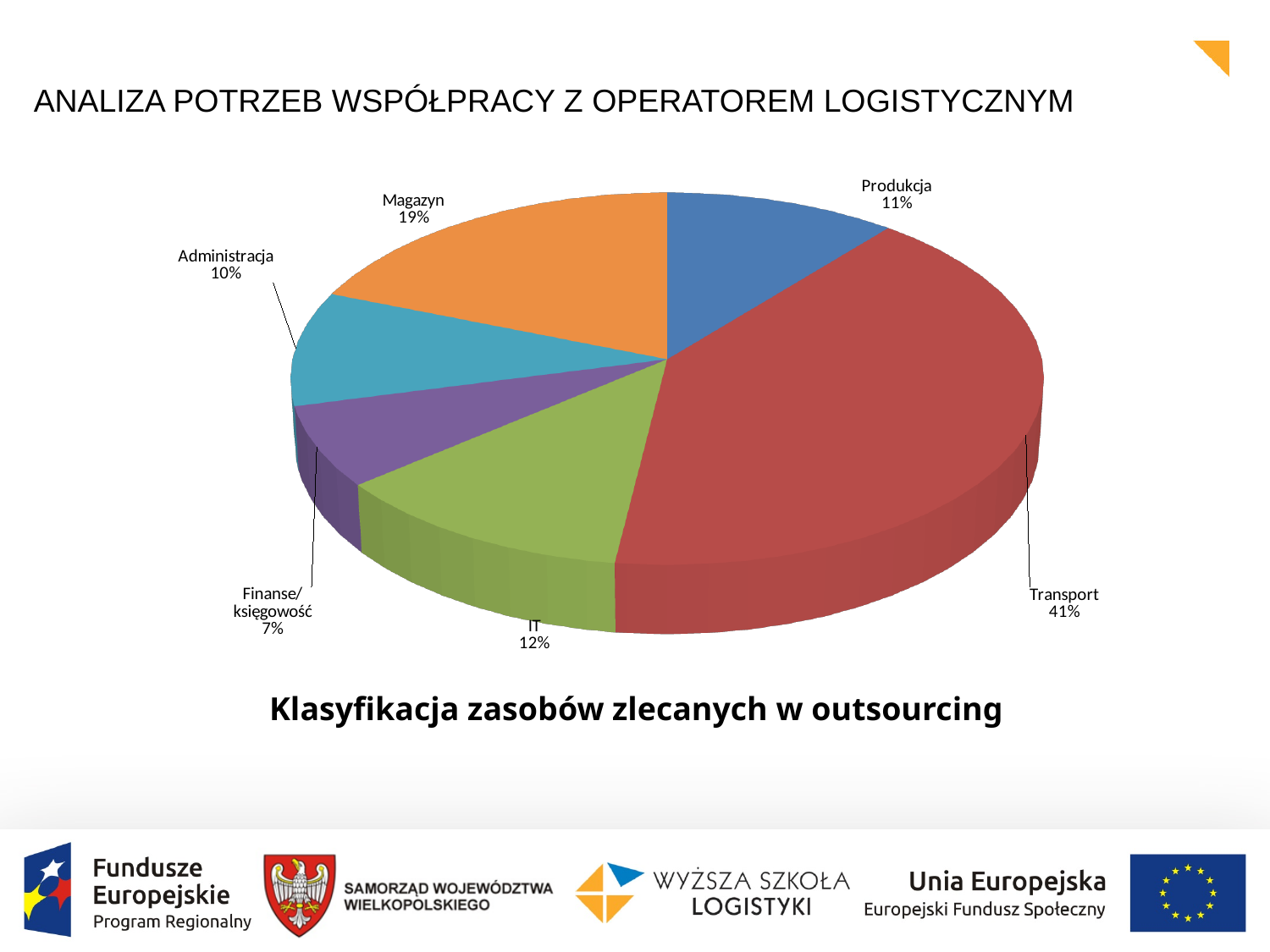
What is the difference in percentage points between Produkcja and Administracja? 1 What share of the pie does Transport have? 41% What is the value shown for Administracja? 10% What is the value shown for Magazyn? 19% Which is larger, the share for IT or the share for Produkcja? IT What kind of chart is shown on the slide? Pie chart What is the value shown for Finanse/księgowość? 7% What is the difference in percentage points between Transport and Magazyn? 22 What is the title printed below the chart? Klasyfikacja zasobów zlecanych w outsourcing Which category has the smallest slice of the pie? Finanse/księgowość Which category has the largest slice of the pie? Transport How many categories are shown in the pie chart? 6